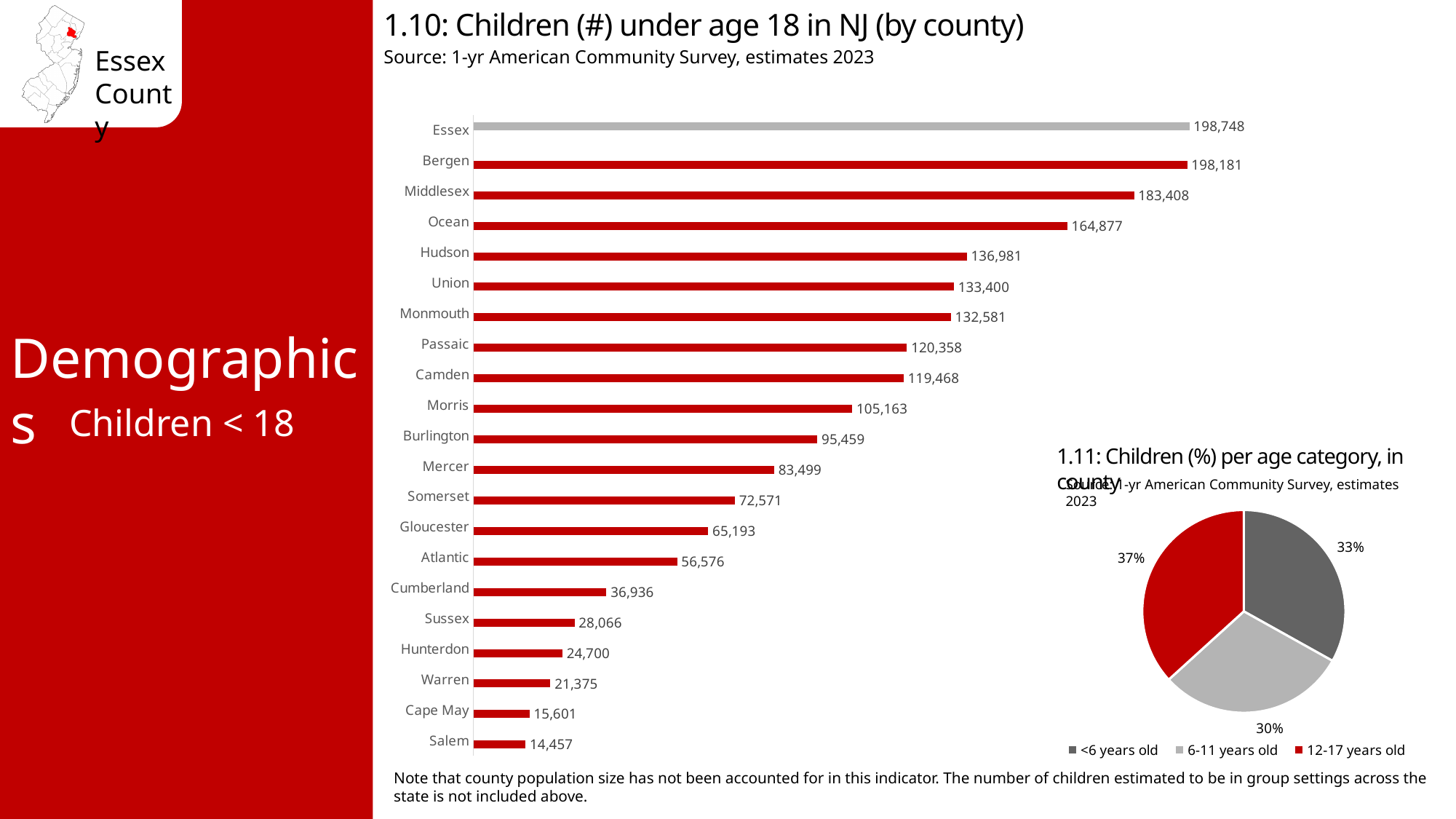
In chart 1.11, which age category has the smallest share? 6-11 years old In chart 1.10, what is the difference between the values for Essex and Bergen? 567 In chart 1.10, which county has the fewest children under age 18? Salem In chart 1.10, what is the value for Hudson? 136,981 In chart 1.11, how many age categories does the legend list? 3 In chart 1.11, what percentage of children are 12-17 years old? 37% What type of chart is chart 1.10? Bar chart In chart 1.10, how many children under age 18 are in Essex County? 198,748 In chart 1.11, what colour is the slice for <6 years old? Dark grey In chart 1.10, how many counties are shown? 21 In chart 1.10, which has a larger value, Passaic or Camden? Passaic In chart 1.10, which county has the most children under age 18? Essex